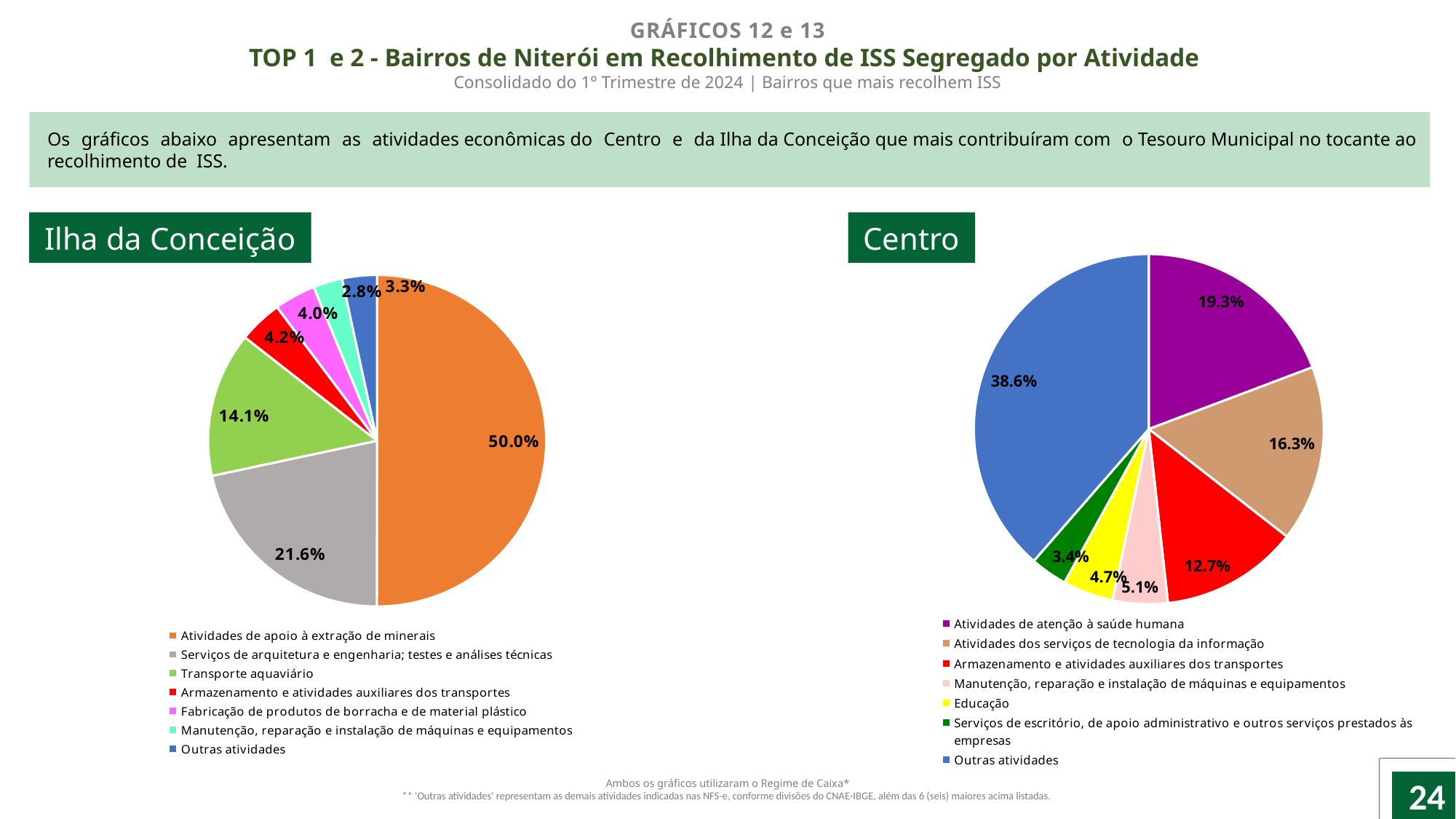
In the Centro chart, what is the value for 'Atividades de atenção à saúde humana'? 19.3% In the Centro chart, what is the value for 'Serviços de escritório, de apoio administrativo e outros serviços prestados às empresas'? 3.4% What type of chart is the Centro chart? Pie chart In the Ilha da Conceição chart, what is the value for 'Transporte aquaviário'? 14.1% In the Ilha da Conceição chart, what is the difference between 'Serviços de arquitetura e engenharia; testes e análises técnicas' and 'Transporte aquaviário'? 7.5% In the Centro chart, what is the difference between 'Atividades dos serviços de tecnologia da informação' and 'Armazenamento e atividades auxiliares dos transportes'? 3.6% In the Ilha da Conceição chart, how many slices does the pie have? 7 In the Centro chart, which is larger: 'Educação' or 'Manutenção, reparação e instalação de máquinas e equipamentos'? Manutenção, reparação e instalação de máquinas e equipamentos In the Ilha da Conceição chart, which activity has the smallest slice? Manutenção, reparação e instalação de máquinas e equipamentos In the Ilha da Conceição chart, what share does 'Atividades de apoio à extração de minerais' have? 50.0% In the Centro chart, which category has the largest slice? Outras atividades In the Centro chart, what colour is the 'Educação' slice? Yellow